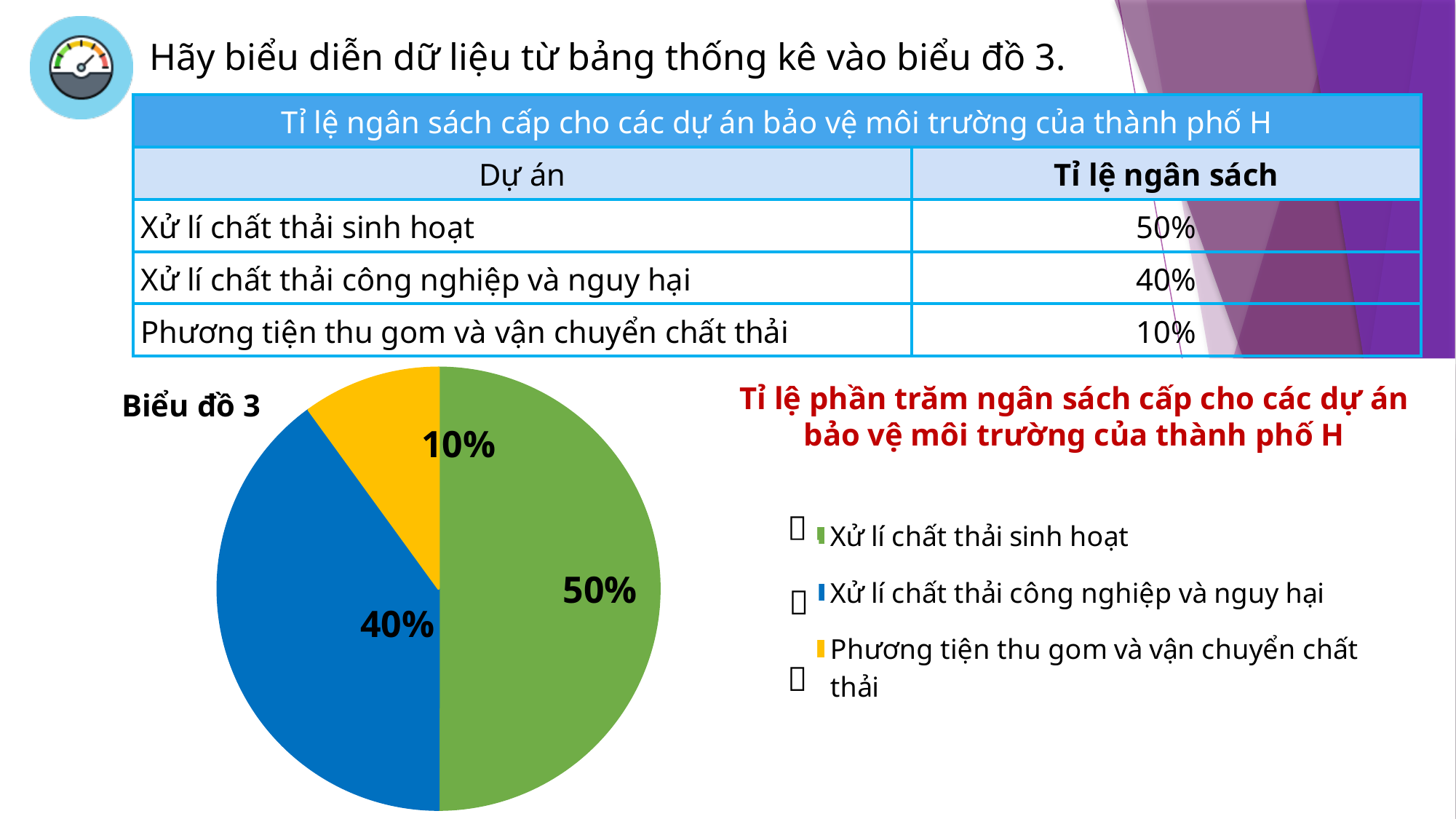
Which category has the smallest slice of the pie? Phương tiện thu gom và vận chuyển chất thải What share of the pie does "Xử lí chất thải sinh hoạt" have? 50% What is the title of the pie chart? Tỉ lệ phần trăm ngân sách cấp cho các dự án bảo vệ môi trường của thành phố H What is the difference between the shares of "Xử lí chất thải sinh hoạt" and "Xử lí chất thải công nghiệp và nguy hại"? 10% What share of the pie does "Phương tiện thu gom và vận chuyển chất thải" have? 10% Which is larger: the slice for "Xử lí chất thải công nghiệp và nguy hại" or the slice for "Phương tiện thu gom và vận chuyển chất thải"? Xử lí chất thải công nghiệp và nguy hại What colour is the slice for "Xử lí chất thải sinh hoạt"? green Which category has the largest slice of the pie? Xử lí chất thải sinh hoạt What kind of chart is shown on the slide? pie chart What is the difference between the shares of "Xử lí chất thải công nghiệp và nguy hại" and "Phương tiện thu gom và vận chuyển chất thải"? 30% What share of the pie does "Xử lí chất thải công nghiệp và nguy hại" have? 40% How many slices does the pie chart have? 3